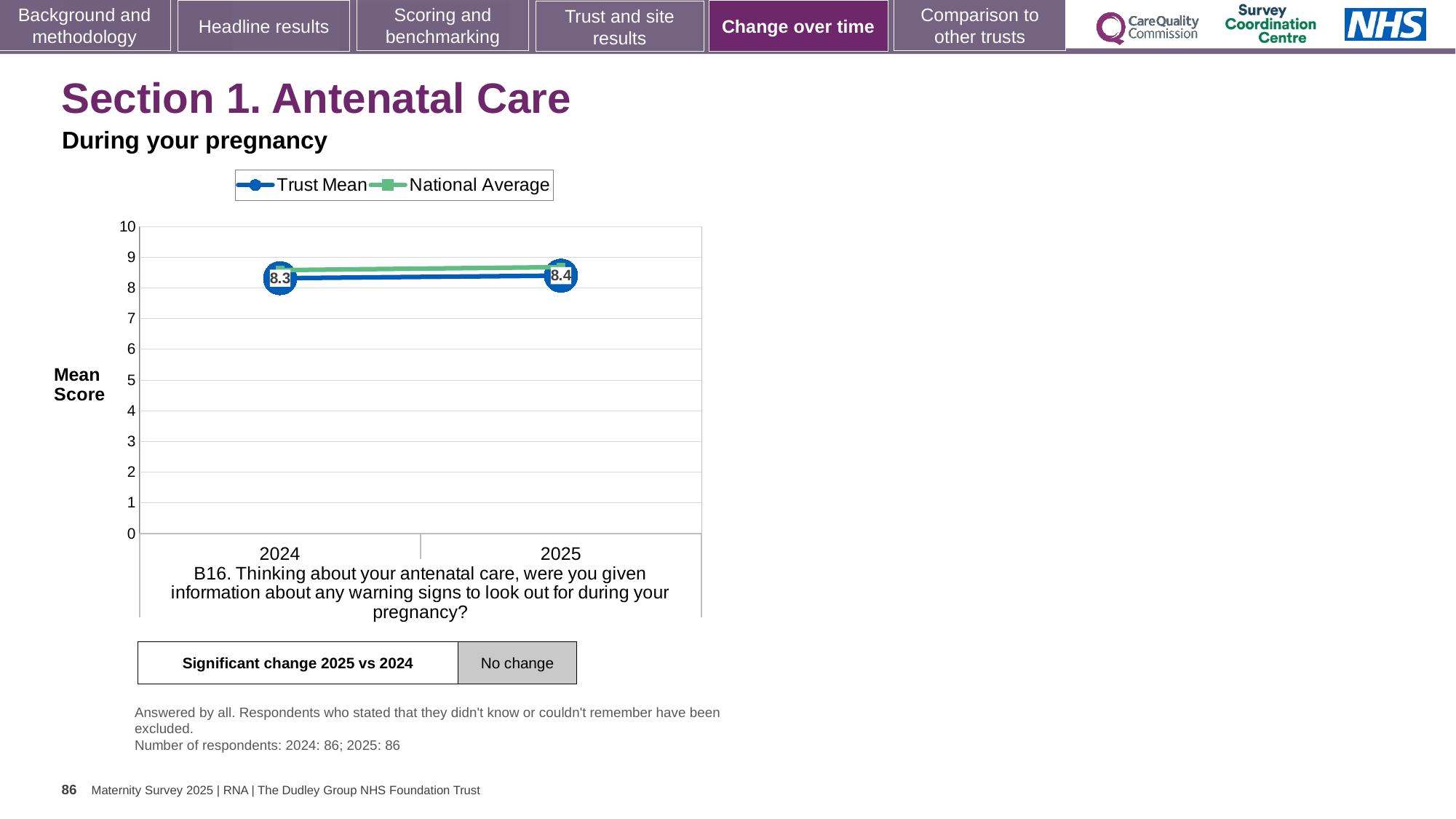
In 2024, which is higher: the Trust Mean or the National Average? National Average What kind of chart is shown on the slide? line chart What is the Trust Mean score for 2025? 8.4 By how much did the Trust Mean change from 2024 to 2025? 0.1 Is the National Average value for 2024 greater or less than 8? greater Does the Trust Mean rise or fall from 2024 to 2025? rise Is the Trust Mean value for 2025 greater or less than 9? less What are the two series named in the legend? Trust Mean and National Average What is the Trust Mean score for 2024? 8.3 What is the label on the y axis of the chart? Mean Score How many years are plotted on the x axis? 2 How many series does the legend list? 2